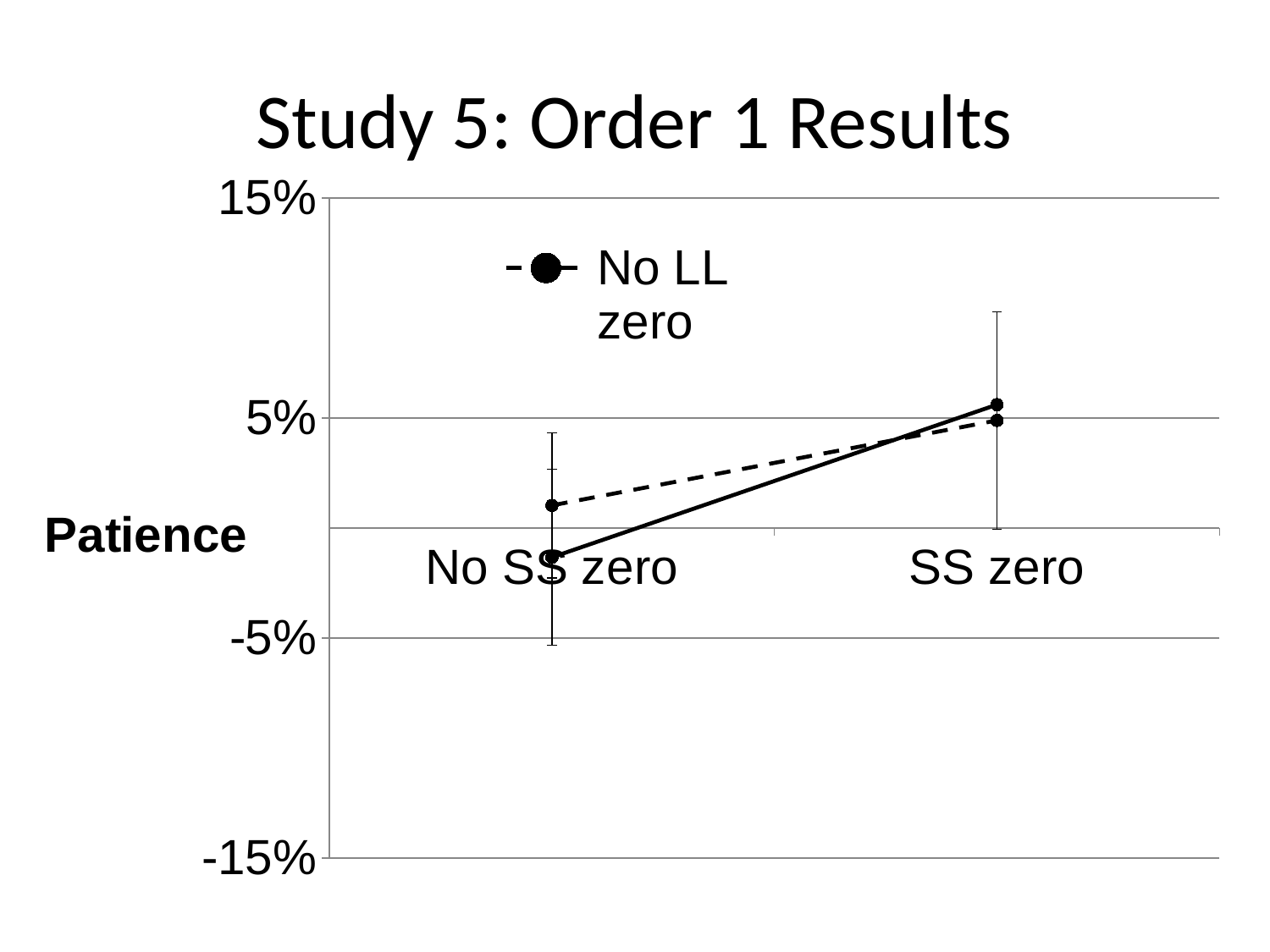
Is the value of the solid line at No SS zero greater or less than 5%? less Is the value for No LL zero at No SS zero greater or less than -5%? greater What label is shown on the vertical axis of the chart? Patience What kind of chart is shown on the slide? line chart What is the title of the slide's chart? Study 5: Order 1 Results Which series name is shown in the chart's legend? No LL zero For the No LL zero series, which category has the higher value, No SS zero or SS zero? SS zero Is the value for No LL zero at SS zero greater or less than 15%? less Does the No LL zero series rise or fall from No SS zero to SS zero? rise Does the solid line rise or fall from No SS zero to SS zero? rise How many categories are shown on the x axis? 2